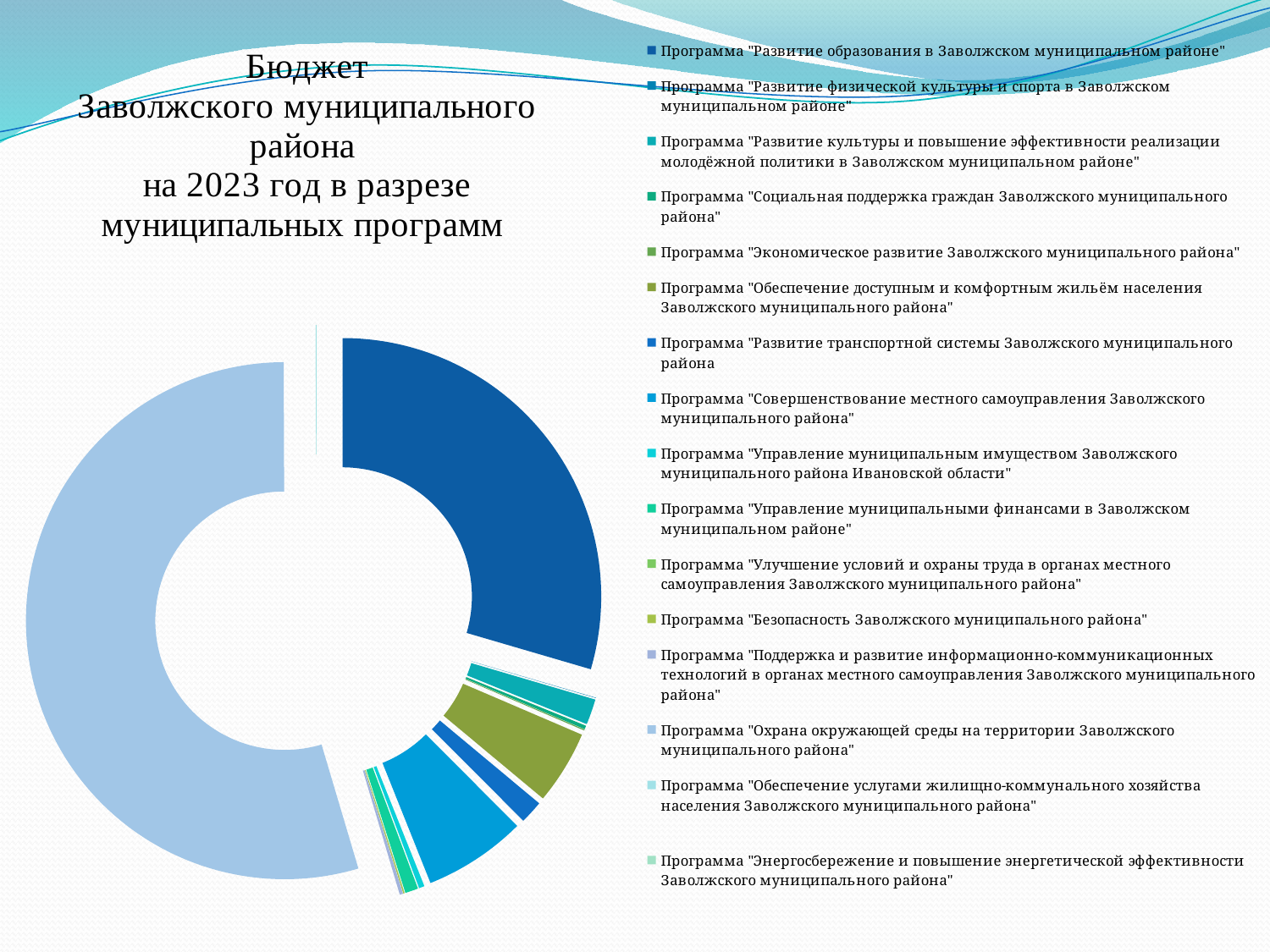
Which legend entry is listed first in the chart legend? Программа "Развитие образования в Заволжском муниципальном районе" How many programs are listed in the chart legend? 16 What kind of chart is shown on the slide? Doughnut (pie) chart Which slice is larger: Программа "Развитие образования в Заволжском муниципальном районе" or Программа "Совершенствование местного самоуправления Заволжского муниципального района"? Программа "Развитие образования в Заволжском муниципальном районе" For which year does the chart show the budget breakdown? 2023 Which slice is larger: Программа "Развитие образования в Заволжском муниципальном районе" or Программа "Безопасность Заволжского муниципального района"? Программа "Развитие образования в Заволжском муниципальном районе" What is the title of the slide with the chart? Бюджет Заволжского муниципального района на 2023 год в разрезе муниципальных программ